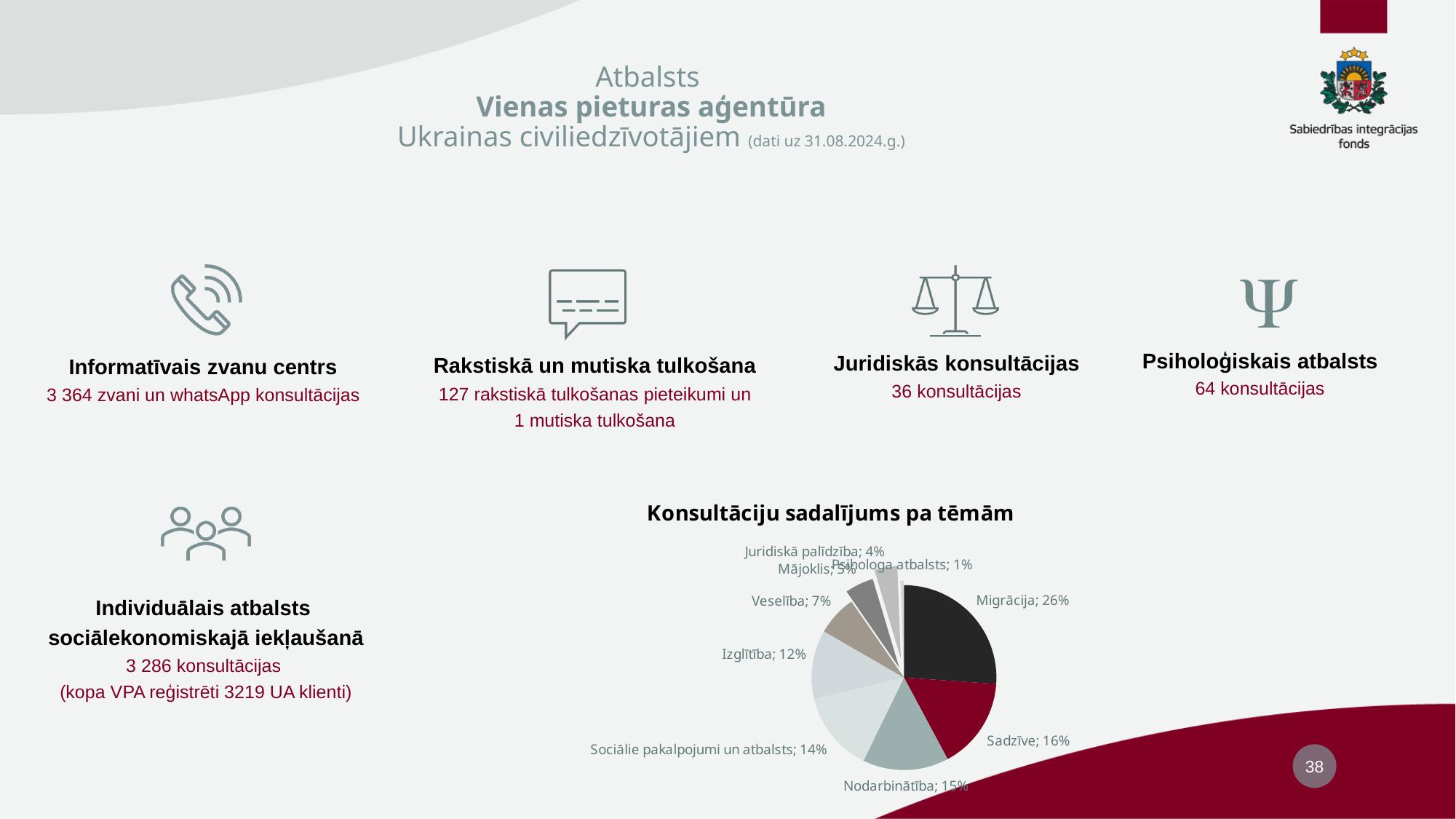
What is the title of the pie chart? Konsultāciju sadalījums pa tēmām What is the combined share of Juridiskā palīdzība and Psihologa atbalsts in the pie chart? 5% What share of the pie chart does Migrācija have? 26% What share of the pie chart does Nodarbinātība have? 15% Which category has the smallest slice in the pie chart? Psihologa atbalsts How many slices does the pie chart have? 9 What share of the pie chart does Veselība have? 7% What kind of chart is shown under the title "Konsultāciju sadalījums pa tēmām"? pie chart What share of the pie chart does Sociālie pakalpojumi un atbalsts have? 14% Which category has the largest slice in the pie chart? Migrācija What is the difference in percentage points between Migrācija and Sadzīve in the pie chart? 10 Which slice is larger in the pie chart, Izglītība or Mājoklis? Izglītība